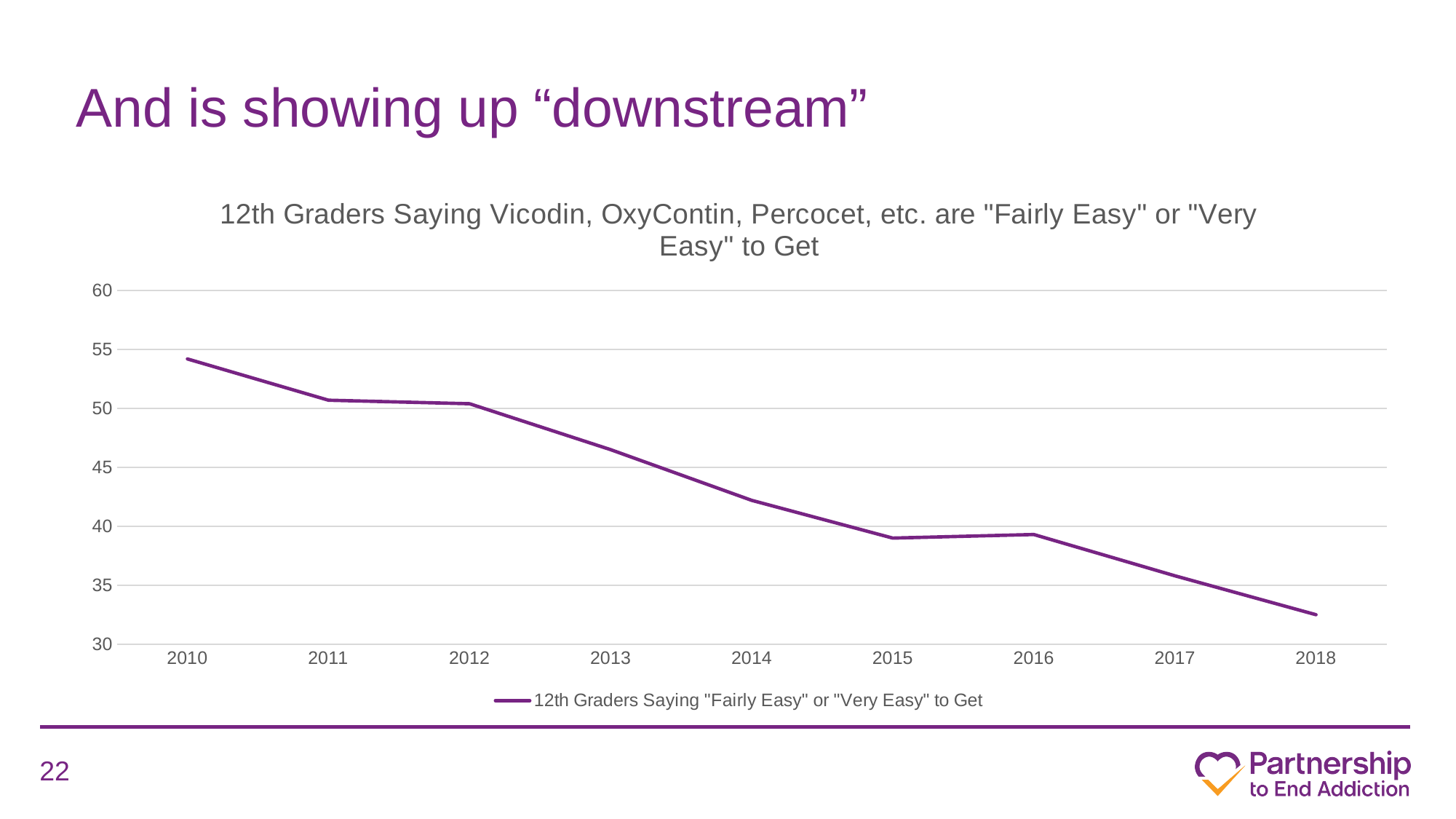
What is the title of the chart? 12th Graders Saying Vicodin, OxyContin, Percocet, etc. are "Fairly Easy" or "Very Easy" to Get Which year has the highest value? 2010 How many years are plotted on the x axis of the chart? 9 Is the value for 2014 greater or less than 45? less What kind of chart is shown on the slide? line chart Which year has the larger value, 2013 or 2016? 2013 Do the values rise or fall from 2010 to 2018? fall Is the value for 2018 greater or less than 35? less Is the value for 2013 greater or less than 50? less How many series does the legend list? 1 Which year has the lowest value? 2018